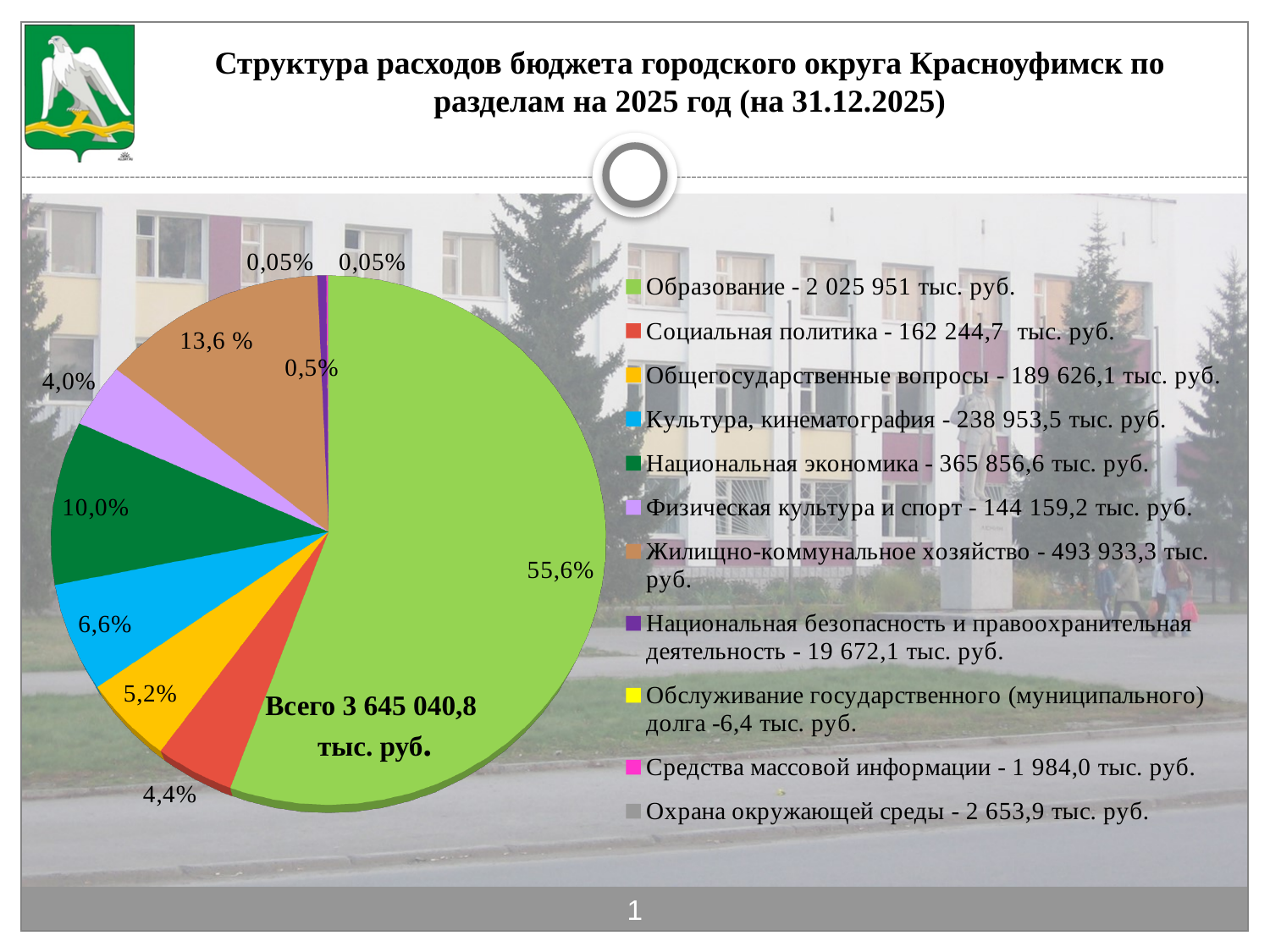
What total amount is printed on the pie chart? 3 645 040,8 тыс. руб. Which category has the largest slice of the pie? Образование By how many percentage points does the share of Жилищно-коммунальное хозяйство exceed the share of Национальная экономика? 3,6 Which slice is larger: Национальная экономика or Культура, кинематография? Национальная экономика What share of the pie does Социальная политика account for? 4,4% What kind of chart is shown on the slide? pie chart What share of the pie does Жилищно-коммунальное хозяйство account for? 13,6 % According to the legend, what is the amount for Образование? 2 025 951 тыс. руб. How many categories does the legend list? 11 According to the legend, what is the amount for Культура, кинематография? 238 953,5 тыс. руб. What share of the pie does Национальная экономика account for? 10,0%